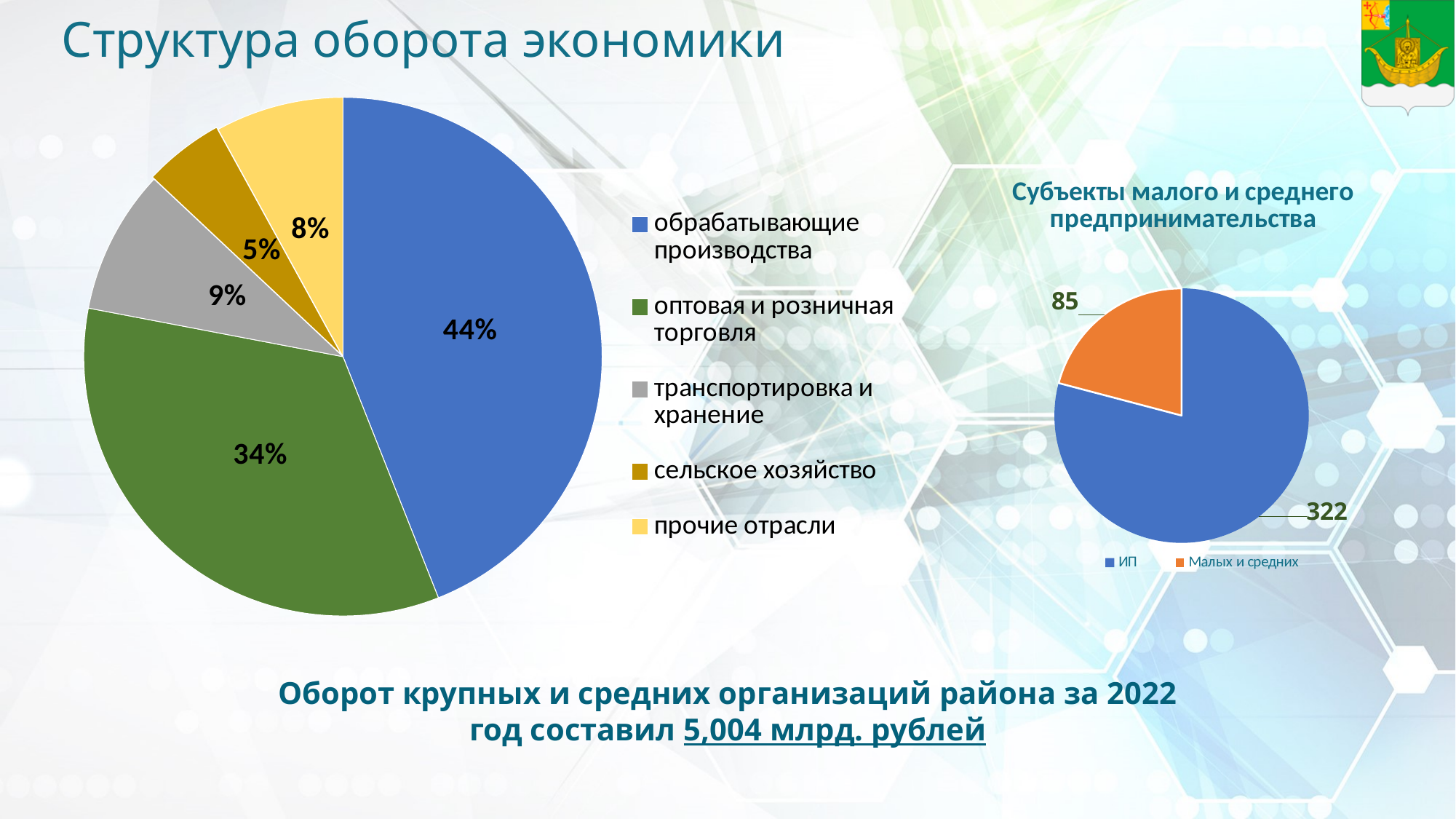
On the left pie chart, what share is shown for оптовая и розничная торговля? 34% On the left pie chart, which category has the largest share? обрабатывающие производства On the left pie chart, what is the difference between the shares of обрабатывающие производства and оптовая и розничная торговля? 10% On the chart 'Субъекты малого и среднего предпринимательства', what is the value for Малых и средних? 85 On the left pie chart, which is larger: прочие отрасли or сельское хозяйство? прочие отрасли On the chart 'Субъекты малого и среднего предпринимательства', what is the value for ИП? 322 On the left pie chart, what share is shown for транспортировка и хранение? 9% On the left pie chart, which category has the smallest share? сельское хозяйство How many categories does the left pie chart show? 5 On the chart 'Субъекты малого и среднего предпринимательства', what is the difference between ИП and Малых и средних? 237 On the left pie chart, what share is shown for обрабатывающие производства? 44% What type of chart is the chart titled 'Субъекты малого и среднего предпринимательства'? pie chart